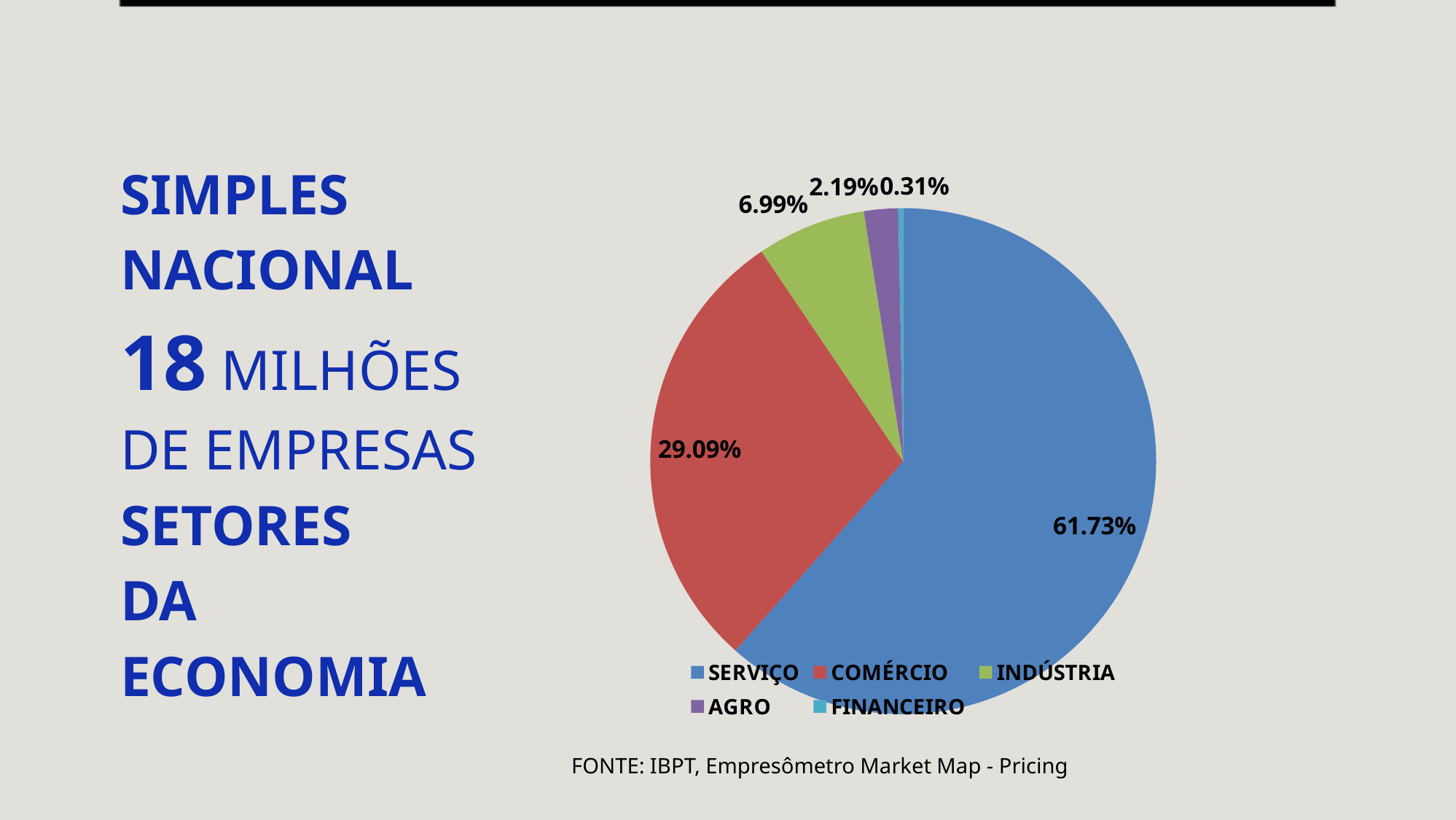
What colour is the COMÉRCIO slice? red Which is larger, the INDÚSTRIA slice or the AGRO slice? INDÚSTRIA What share of the pie does SERVIÇO have? 61.73% What kind of chart is shown on the slide? pie chart Which sector has the largest slice of the pie? SERVIÇO What share of the pie does AGRO have? 2.19% What share of the pie does FINANCEIRO have? 0.31% How many sectors are shown in the pie chart? 5 Which sector has the smallest slice of the pie? FINANCEIRO What is the difference between the SERVIÇO and COMÉRCIO shares? 32.64% What share of the pie does COMÉRCIO have? 29.09% What share of the pie does INDÚSTRIA have? 6.99%